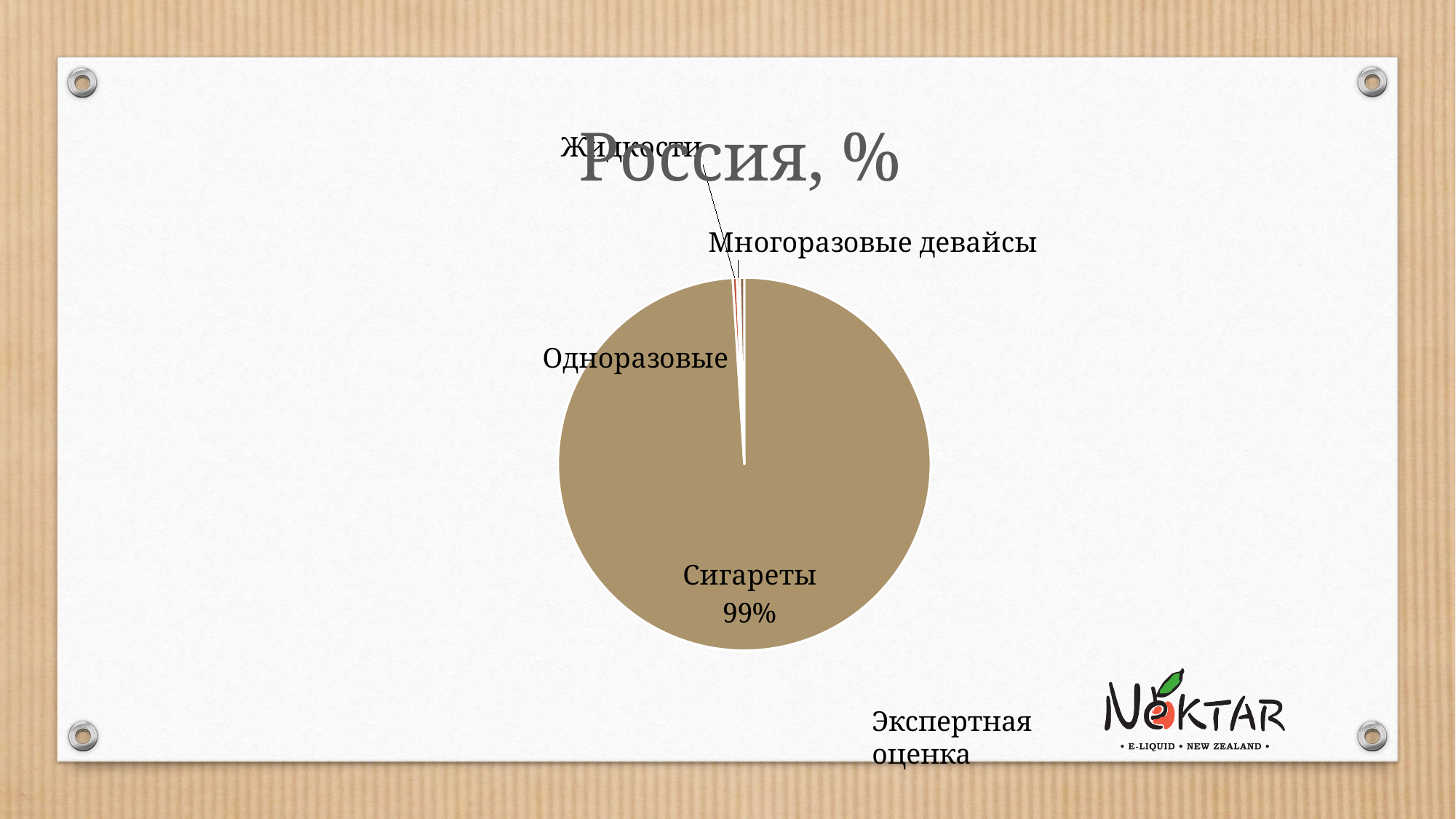
How many categories are shown in the pie chart? 4 What is the title of the chart? Россия, % Which is larger, the slice for Сигареты or the slice for Одноразовые? Сигареты Which is larger, the slice for Сигареты or the slice for Жидкости? Сигареты Which is larger, the slice for Многоразовые девайсы or the slice for Сигареты? Сигареты What share of the pie does Сигареты take? 99% Which category has the largest slice of the pie? Сигареты What kind of chart is shown on the slide? Pie chart What value is printed for the Сигареты slice? 99% What note is printed below the chart about the source of the data? Экспертная оценка